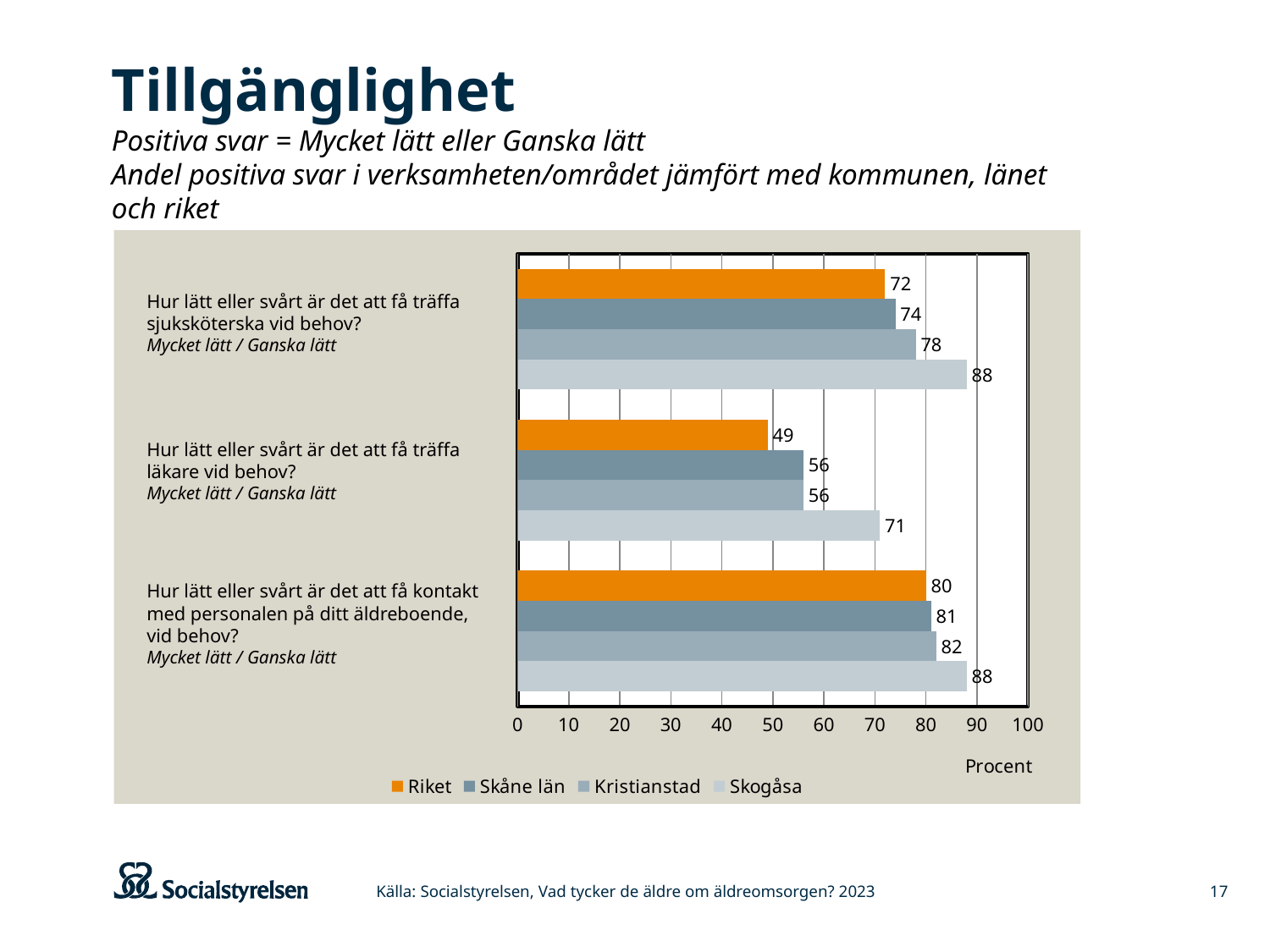
What is the value for Skogåsa on the question about meeting a nurse when needed (träffa sjuksköterska vid behov)? 88 How many series does the legend list? 4 How many question categories are shown on the chart? 3 What is the value for Riket on the question about meeting a doctor when needed (träffa läkare vid behov)? 49 Which series has the highest value on the question about meeting a doctor when needed? Skogåsa What is the value for Kristianstad on the question about getting in contact with staff at the care home (kontakt med personalen)? 82 Which is larger: Kristianstad on the nurse question or Kristianstad on the doctor question? Kristianstad on the nurse question What is the value for Skåne län on the question about meeting a nurse when needed? 74 Which series has the lowest value on the question about getting in contact with staff at the care home? Riket What kind of chart is shown on the slide? Bar chart What is the difference between Skogåsa and Riket on the question about meeting a doctor when needed? 22 What is the unit label shown on the x axis? Procent